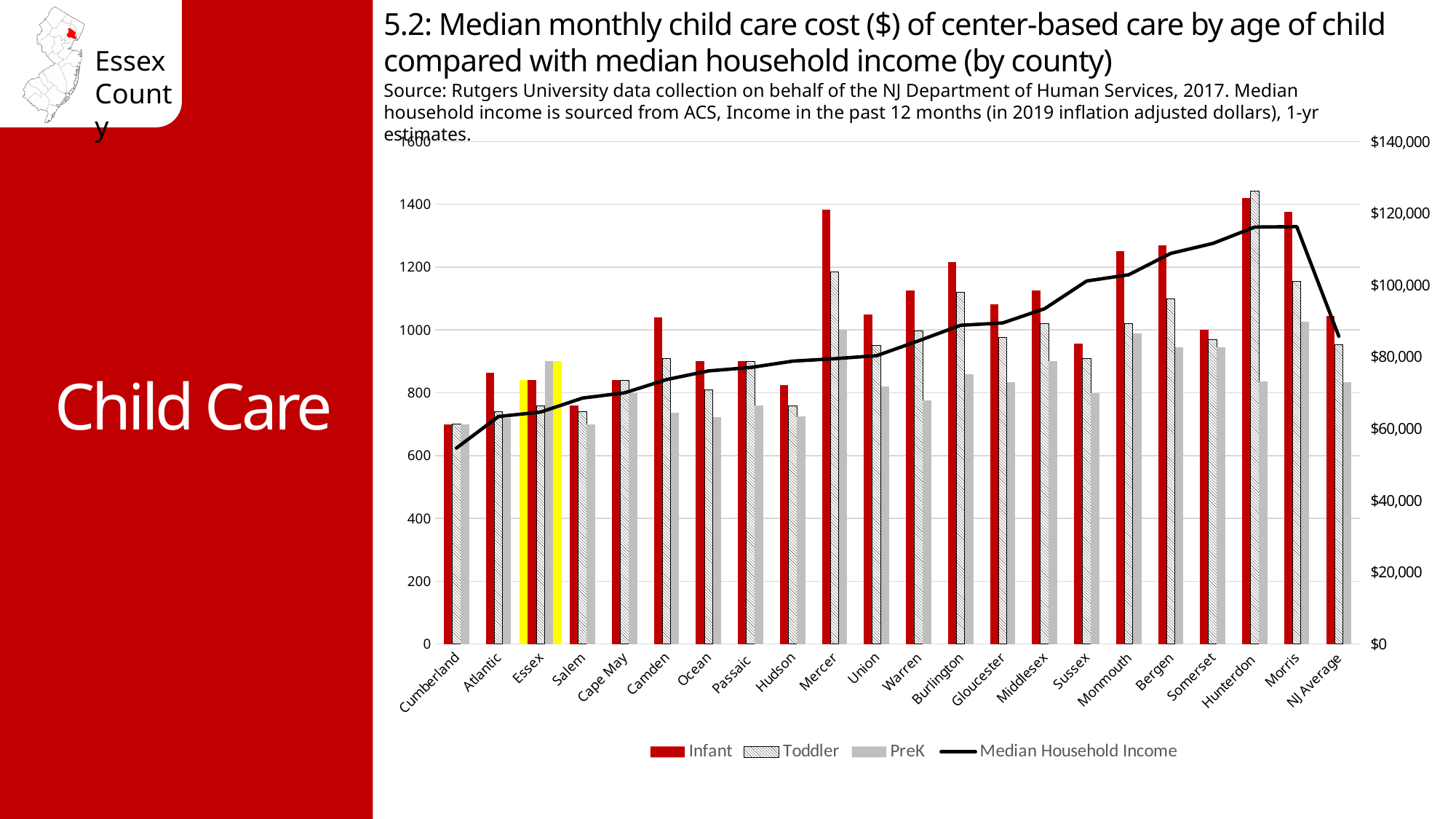
Which category has the lowest Infant bar? Cumberland What kind of chart is used to show the child care costs by county? bar chart How many series does the legend list? 4 Is the Toddler value for Hunterdon greater or less than 1400? greater Which county's bars are highlighted in yellow on the chart? Essex Is the Infant value for Cumberland greater or less than 800? less Does the Median Household Income line generally rise or fall from Cumberland to Morris? rise Is the Infant value for Essex greater or less than 800? greater Which category has the highest Toddler bar? Hunterdon Which is larger, the Infant value for Mercer or the Infant value for Camden? Mercer How many counties/categories are shown along the x axis? 22